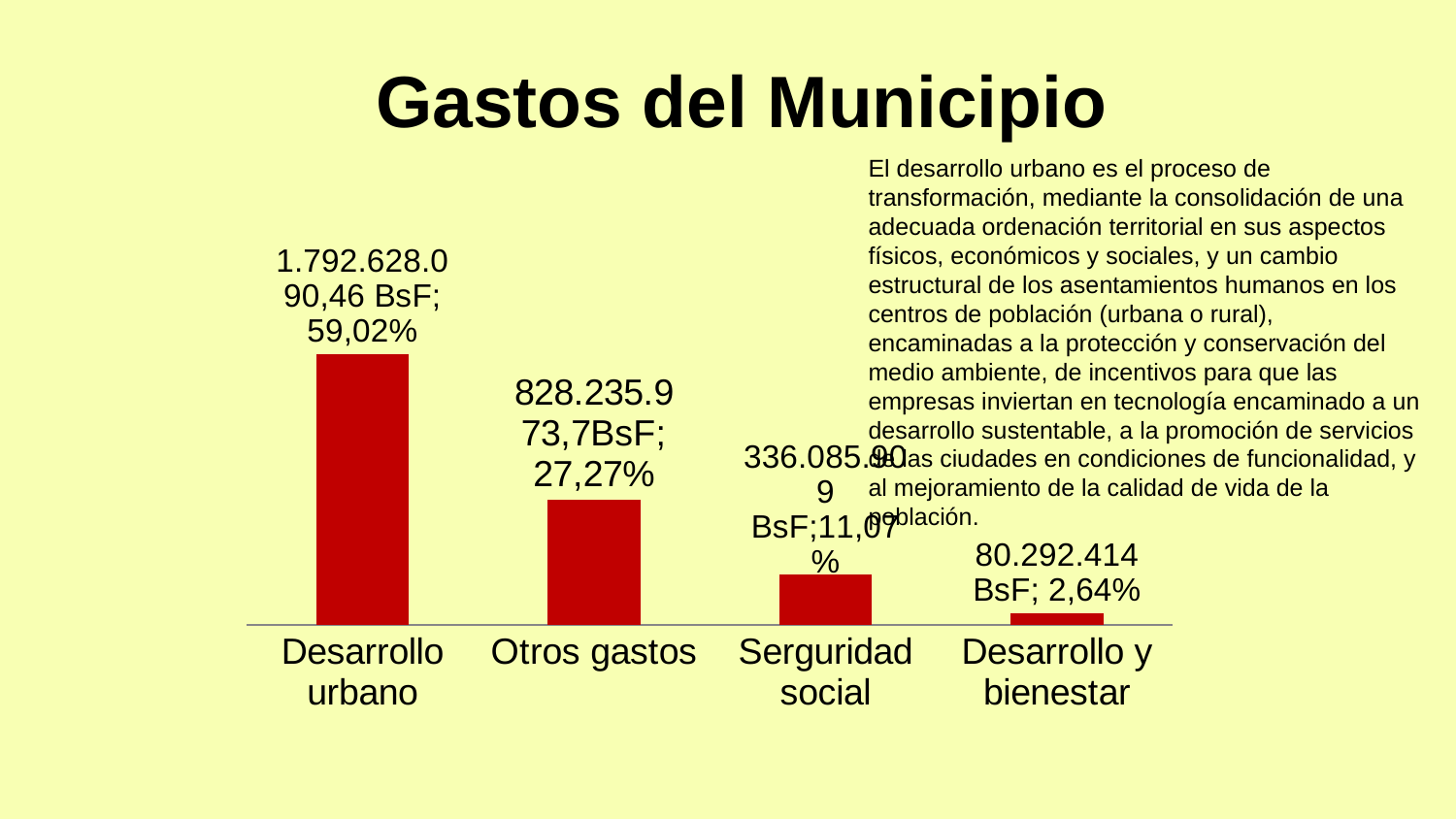
Which is larger, Otros gastos or Serguridad social? Otros gastos What type of chart is shown on the slide? bar chart What percentage share is shown for Desarrollo y bienestar? 2,64% What is the title of the slide containing the chart? Gastos del Municipio What percentage share is shown for Otros gastos? 27,27% What percentage share is shown for Desarrollo urbano? 59,02% Which category has the highest value? Desarrollo urbano Do the bar values rise or fall from left to right along the x axis? fall What percentage share is shown for Serguridad social? 11,07% How many categories are shown in the chart? 4 Which category has the lowest value? Desarrollo y bienestar What amount in BsF is shown for Desarrollo y bienestar? 80.292.414 BsF